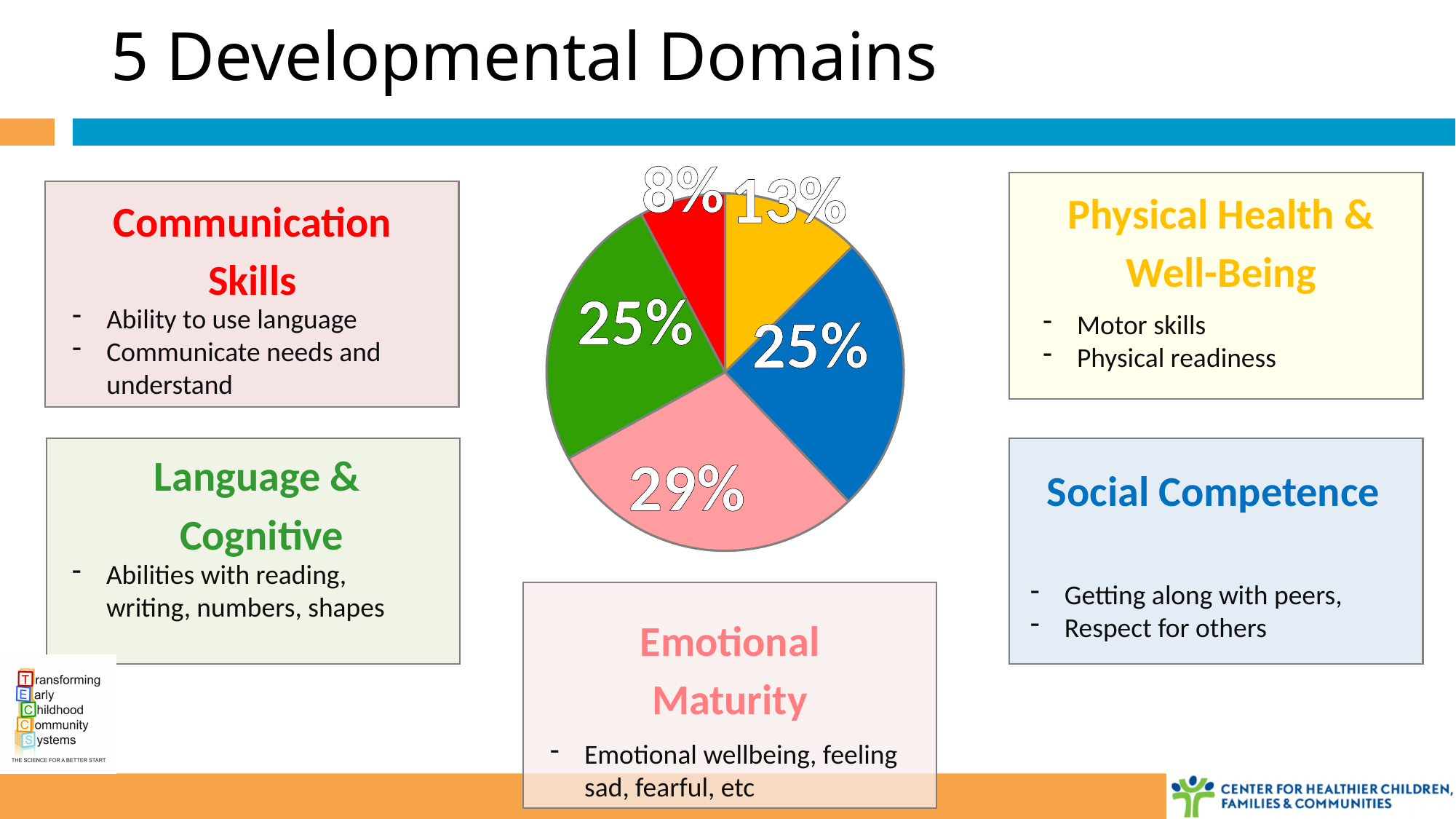
What percentage is shown on the blue slice of the pie chart? 25% Which slice of the pie chart has the smallest share? the red slice (8%) How many slices does the pie chart have? 5 What is the title of the slide containing the pie chart? 5 Developmental Domains What is the difference between the pink slice and the yellow slice in the pie chart? 16% What percentage is shown on the pink slice of the pie chart? 29% What kind of chart is shown on the slide? pie chart Which is larger in the pie chart, the yellow slice or the red slice? the yellow slice What percentage is shown on the red slice of the pie chart? 8% How many slices in the pie chart are labelled 25%? 2 What percentage is shown on the yellow slice of the pie chart? 13% Which slice of the pie chart has the largest share? the pink slice (29%)